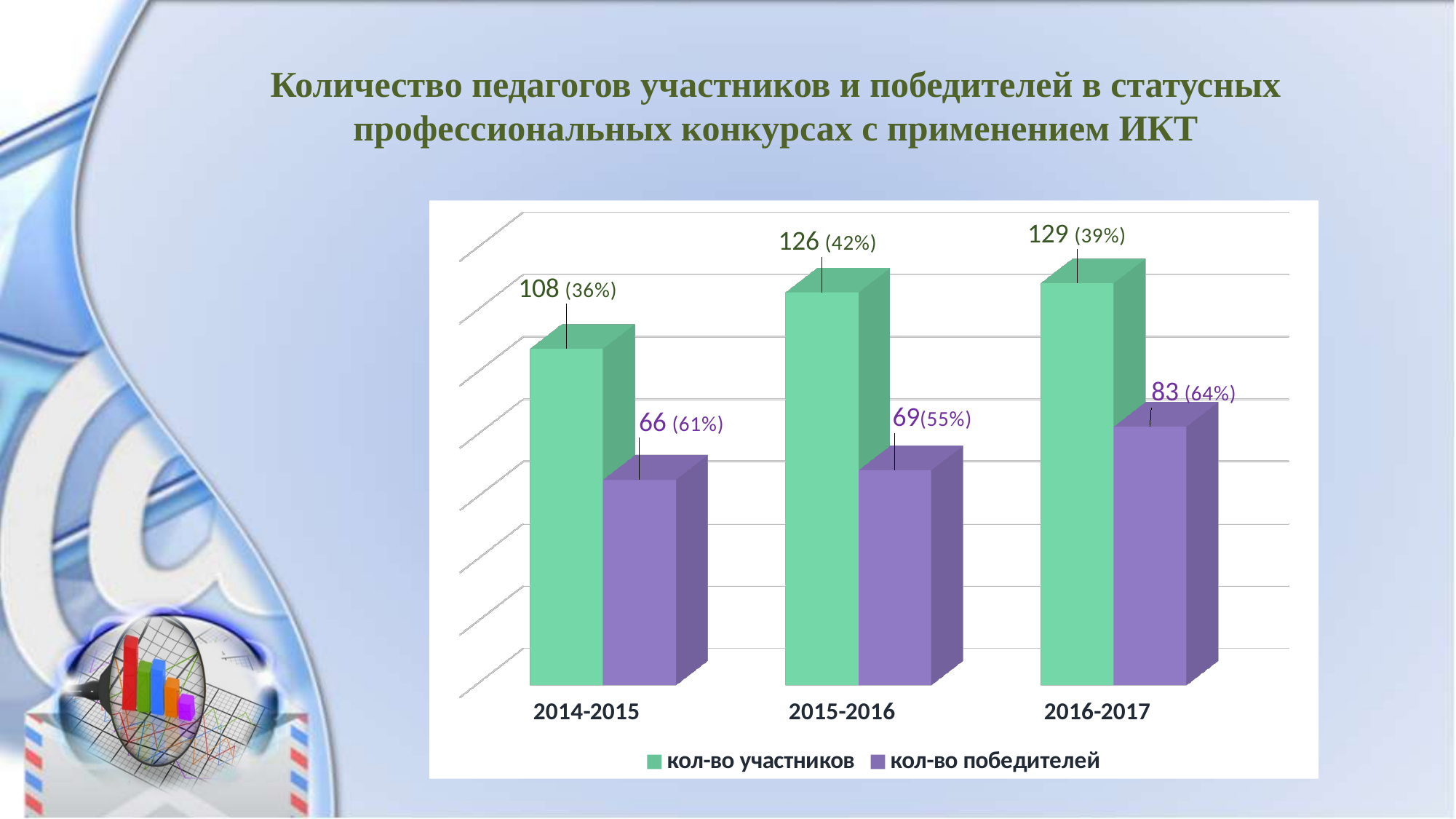
Which period has the highest number of participants? 2016-2017 What is the number of participants (кол-во участников) in 2014-2015? 108 What is the number of winners (кол-во победителей) in 2016-2017? 83 What percentage is shown next to the participants value for 2015-2016? 42% Which period has the lowest number of winners? 2014-2015 What kind of chart is shown on the slide? Bar chart How many periods are shown on the x axis? 3 What is the difference between the number of winners in 2016-2017 and in 2015-2016? 14 Does the number of participants rise or fall from 2014-2015 to 2016-2017? Rise What is the difference between the number of participants in 2016-2017 and in 2014-2015? 21 How many series does the legend list? 2 Which is larger: the number of winners in 2015-2016 or in 2014-2015? 2015-2016